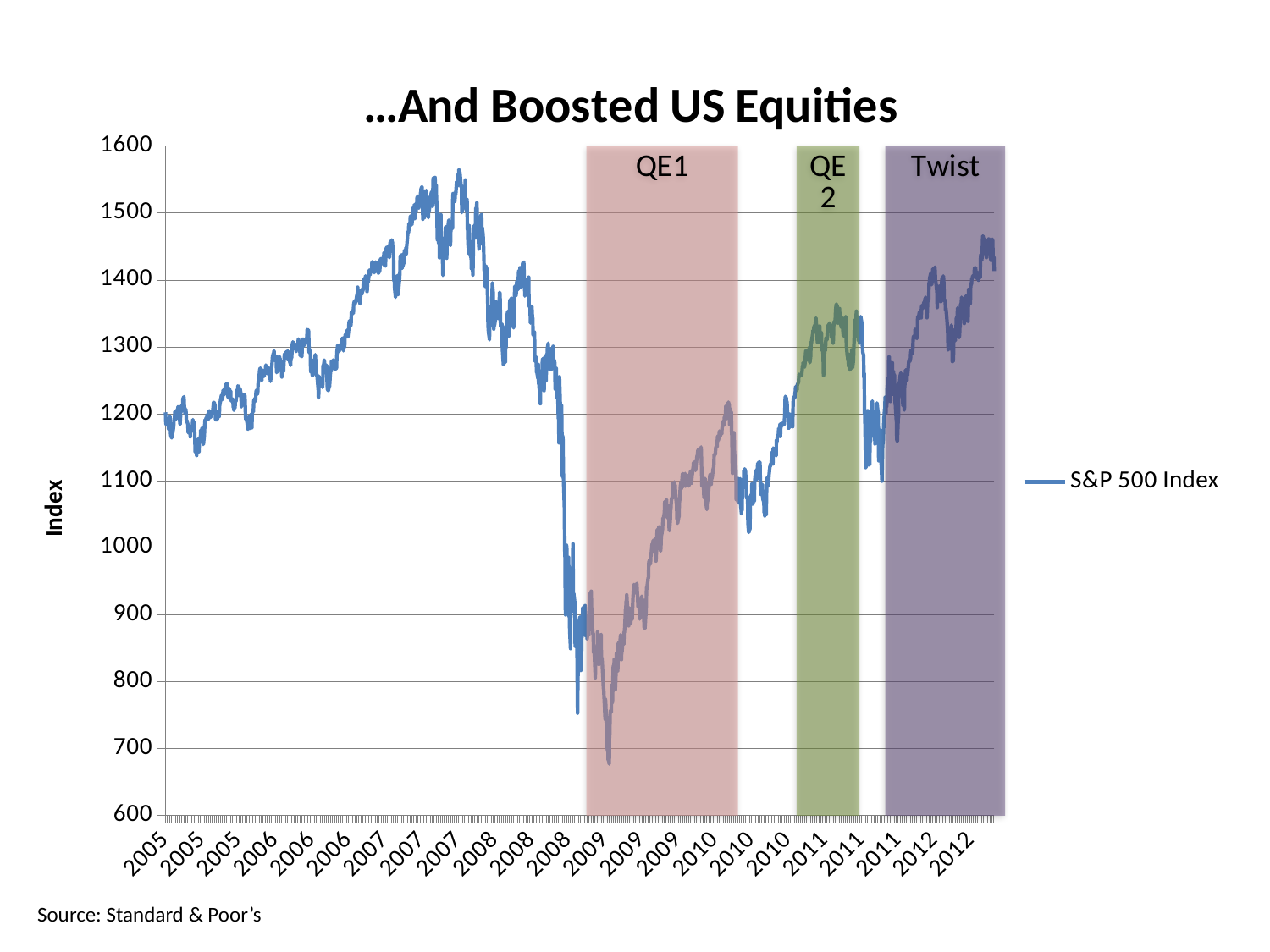
What series name appears in the legend? S&P 500 Index Did the S&P 500 Index rise or fall during 2008? fall Did the S&P 500 Index rise or fall over the Twist shaded period? rise Is the peak value of the S&P 500 Index in 2007 greater or less than 1500? greater Is the lowest value of the S&P 500 Index during the QE1 period greater or less than 800? less Which is higher: the S&P 500 Index peak in 2007 or its peak during the QE2 period? the 2007 peak Is the value of the S&P 500 Index at the start of 2005 greater or less than 1100? greater What kind of chart is shown on the slide? line chart How many series does the legend list? 1 Did the S&P 500 Index rise or fall during the QE1 shaded period? rise What is the title of the chart? ...And Boosted US Equities